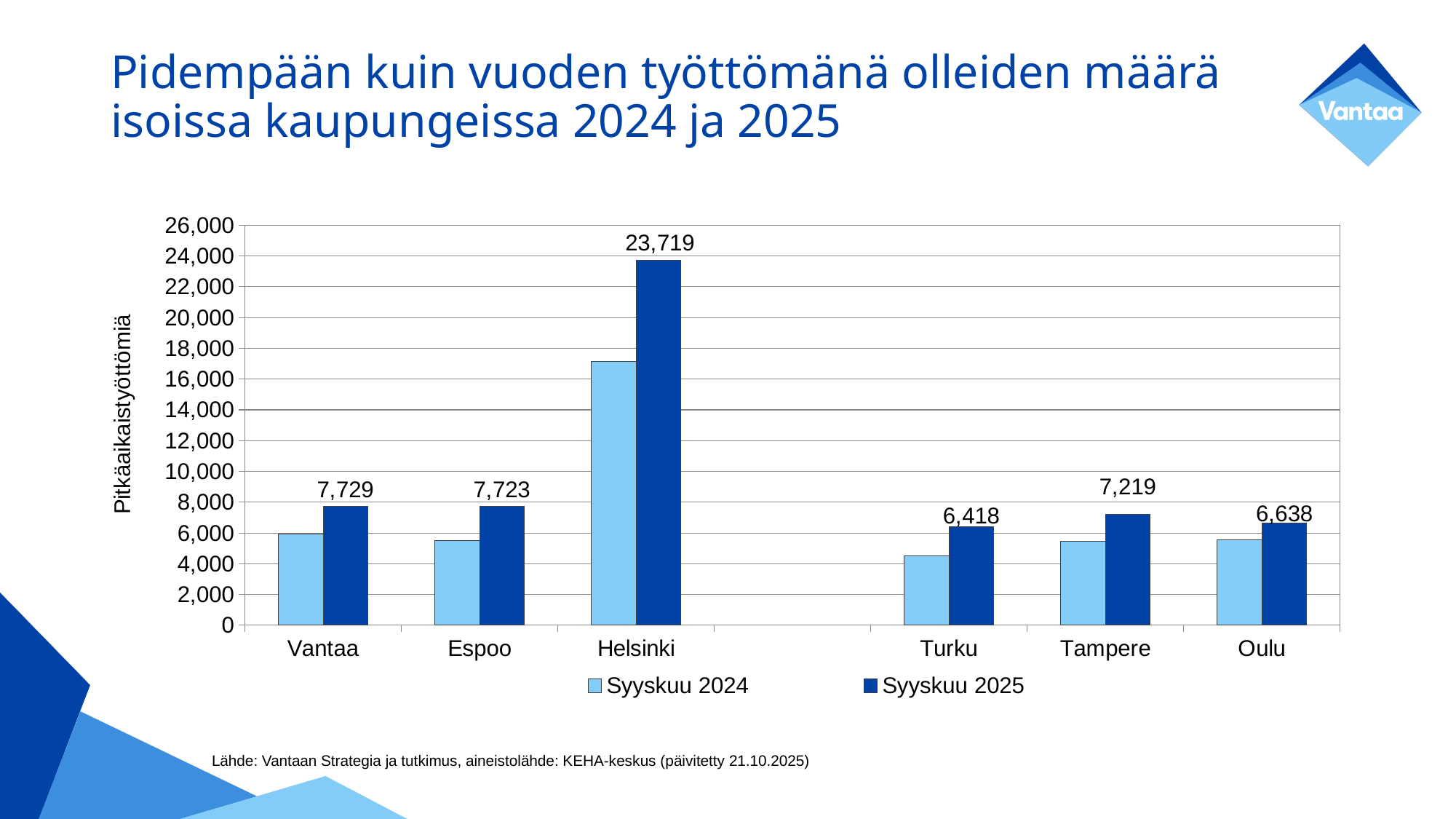
Which city has the lowest value in Syyskuu 2025? Turku Is the value for Helsinki in Syyskuu 2024 greater or less than 16,000? greater How many cities are shown on the x axis? 6 How many series does the legend list? 2 What is the value for Helsinki in Syyskuu 2025? 23,719 Which is larger in Syyskuu 2025, Tampere or Oulu? Tampere What is the difference between Tampere and Oulu in Syyskuu 2025? 581 Which city has the highest value in Syyskuu 2025? Helsinki What is the difference between Helsinki and Vantaa in Syyskuu 2025? 15,990 What is the value for Turku in Syyskuu 2025? 6,418 Is the value for Turku in Syyskuu 2024 greater or less than 6,000? less What is the value for Oulu in Syyskuu 2025? 6,638